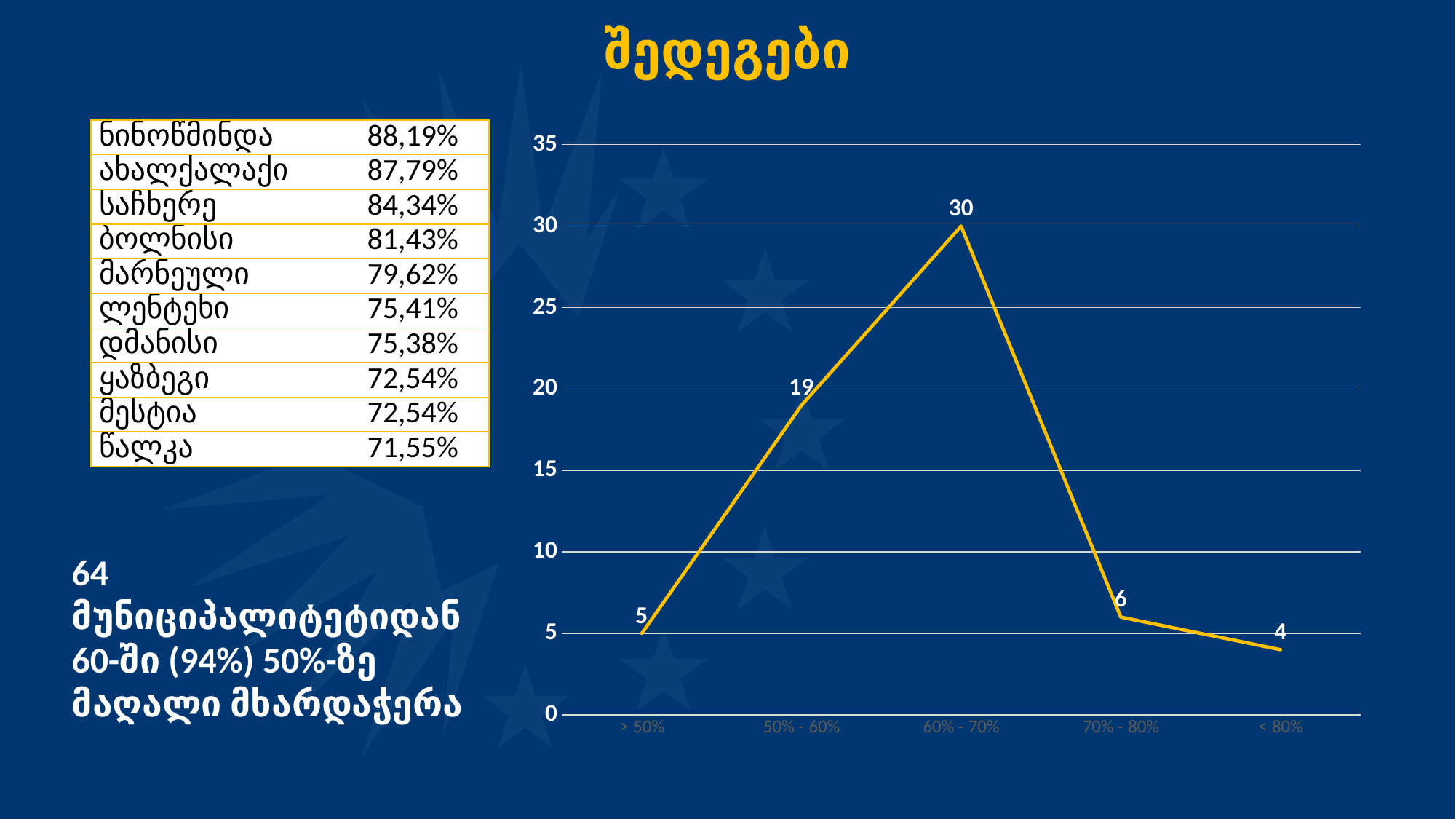
Which category has the lowest value? < 80% What is the value for the "< 80%" category? 4 What is the highest value shown on the y axis? 35 How many categories are plotted on the x axis? 5 Which category has the highest value? 60% - 70% What is the value for the "60% - 70%" category? 30 What is the value for the "> 50%" category? 5 What is the value for the "50% - 60%" category? 19 What type of chart is shown on the slide? line chart Do the values rise or fall from "60% - 70%" to "< 80%"? fall What is the difference between the values for "60% - 70%" and "50% - 60%"? 11 Which is larger, the value for "70% - 80%" or the value for "> 50%"? 70% - 80%